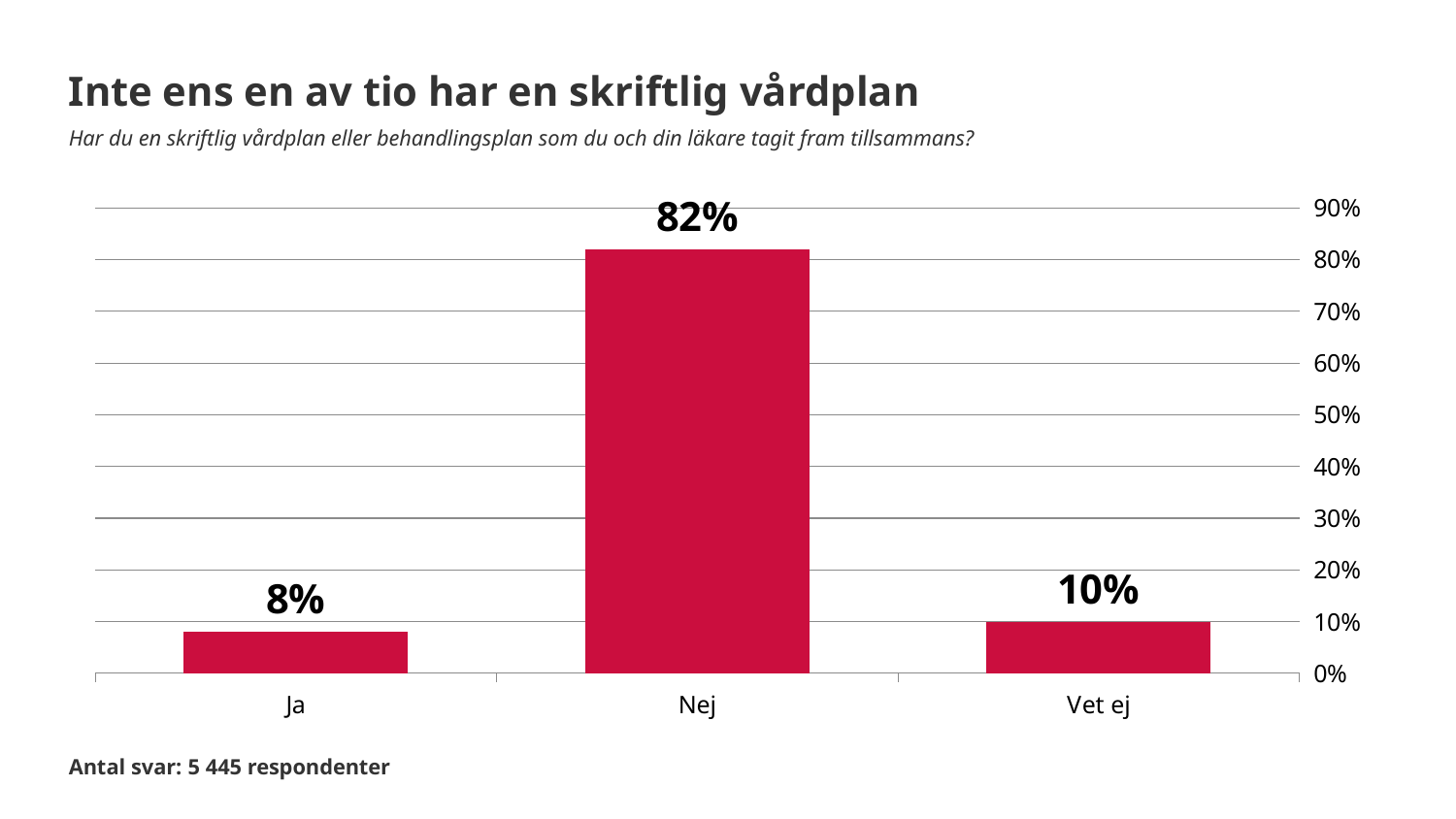
What is the value for Vet ej? 10% Which category has the highest value? Nej What is the difference between the values for Nej and Vet ej? 72% What kind of chart is shown on the slide? bar chart What is the value for Ja? 8% How many respondents answered the survey, according to the note below the chart? 5 445 What is the difference between the values for Vet ej and Ja? 2% Which is larger, the value for Ja or the value for Vet ej? Vet ej How many categories are shown on the x axis? 3 What is the value for Nej? 82% Which category has the lowest value? Ja Is the value for Nej greater or less than 50%? greater